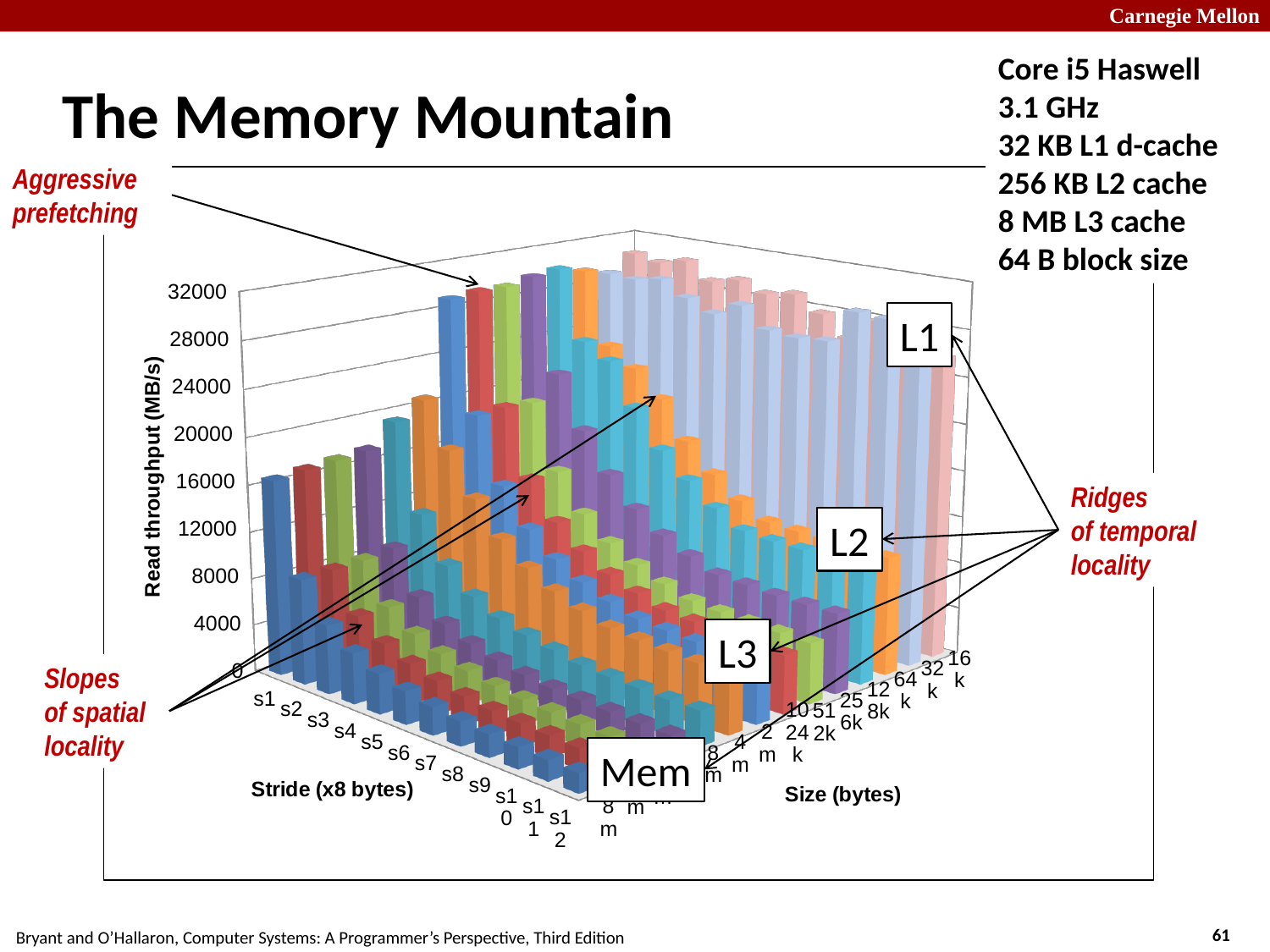
What kind of chart is shown on the slide? bar chart What is the highest tick value shown on the vertical axis of the chart? 32000 For the 8m size row, is the read throughput at stride s12 greater or less than 8000? less For stride s1, does read throughput rise or fall as the working-set size increases from 16k to 8m? fall For the 8m size row, which stride has the higher read throughput, s1 or s12? s1 For the 8m size row, does read throughput rise or fall as the stride increases from s1 to s12? fall For stride s1, which size has the higher read throughput, 16k or 8m? 16k What is the label of the vertical axis of the chart? Read throughput (MB/s) For the 8m size row, which stride has the highest read throughput? s1 How many stride categories (s1 through s12) are shown along the stride axis? 12 For the 8m size row, is the read throughput at stride s1 greater or less than 12000? greater What is the title of the chart on the slide? The Memory Mountain